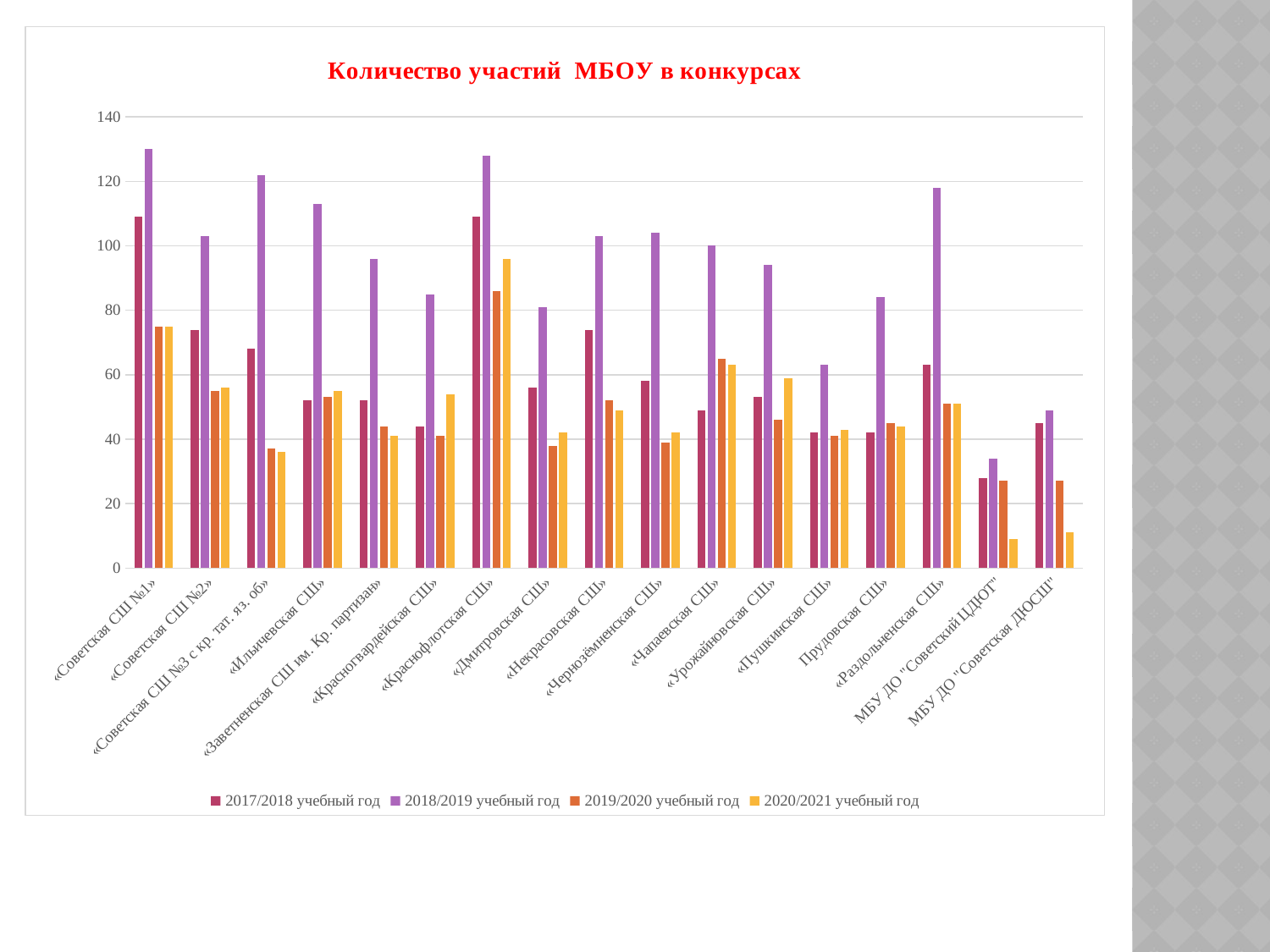
For «Краснофлотская СШ», which is larger: the value for 2019/2020 учебный год or for 2020/2021 учебный год? 2020/2021 учебный год What is the title of the chart? Количество участий МБОУ в конкурсах Which institution has the lowest value for 2018/2019 учебный год? МБУ ДО "Советский ЦДЮТ" Is the value for «Советская СШ №1» in 2018/2019 учебный год greater or less than 120? greater Is the value for МБУ ДО "Советский ЦДЮТ" in 2020/2021 учебный год greater or less than 20? less For «Чапаевская СШ», which is larger: the value for 2017/2018 учебный год or for 2018/2019 учебный год? 2018/2019 учебный год Is the value for «Ильичевская СШ» in 2018/2019 учебный год greater or less than 100? greater Which institution has the highest value for 2020/2021 учебный год? «Краснофлотская СШ» How many institutions (categories) are shown on the x axis? 17 Which series is shown in purple in the legend? 2018/2019 учебный год How many series does the legend list? 4 What kind of chart is shown on the slide? bar chart